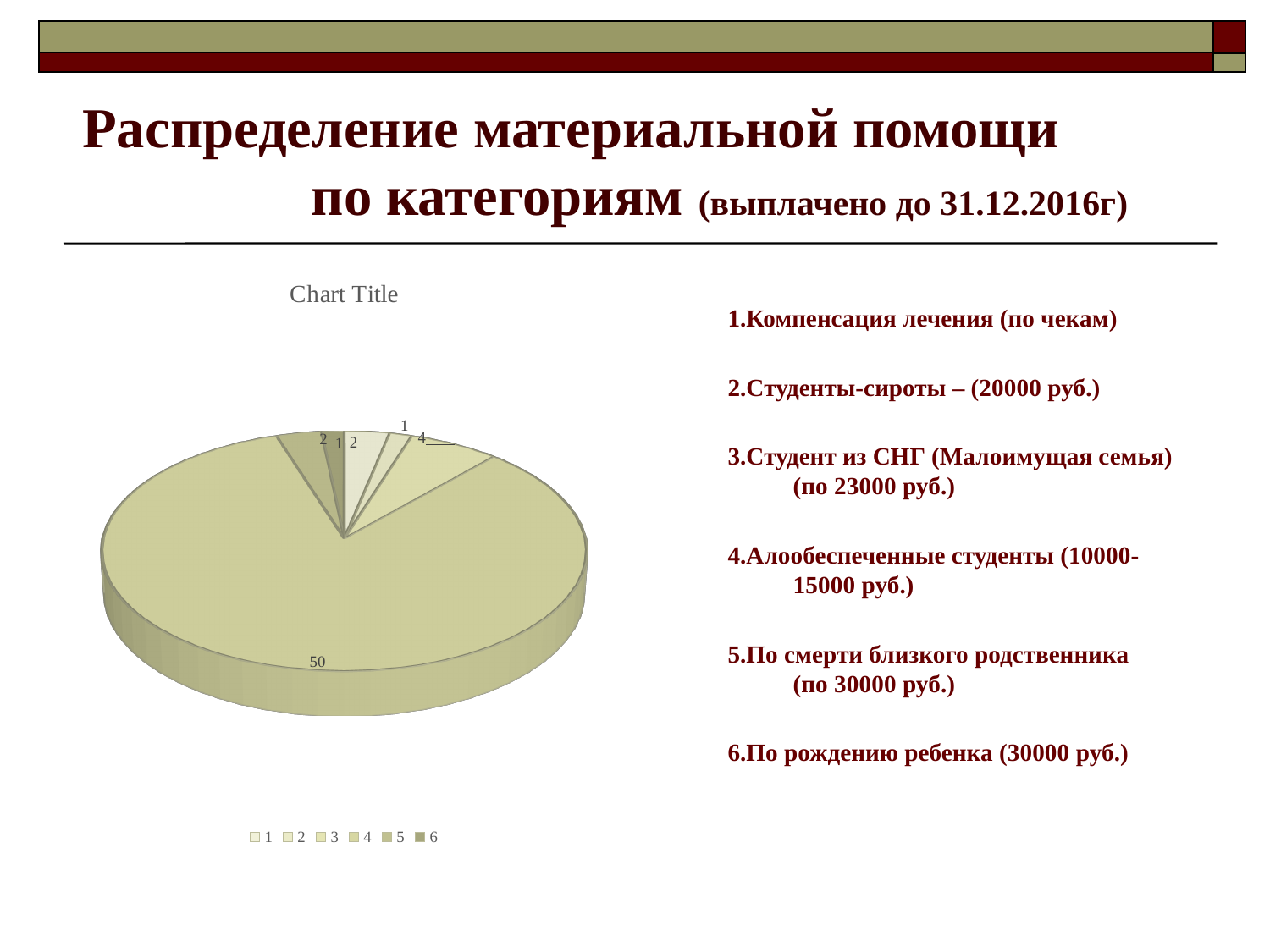
What are the legend entries of the pie chart? 1, 2, 3, 4, 5, 6 What kind of chart is shown on the slide? pie chart What is the smallest value printed on any slice of the pie chart? 1 How many entries does the legend of the pie chart list? 6 What is the value printed on the largest slice of the pie chart? 50 Which is larger: the slice labelled 50 or the slice labelled 4? the slice labelled 50 What is the total of all the values printed on the pie chart slices? 60 How many slices does the pie chart have? 6 What is the difference between the largest slice value (50) and the slice labelled 4? 46 What is the title shown above the pie chart? Chart Title